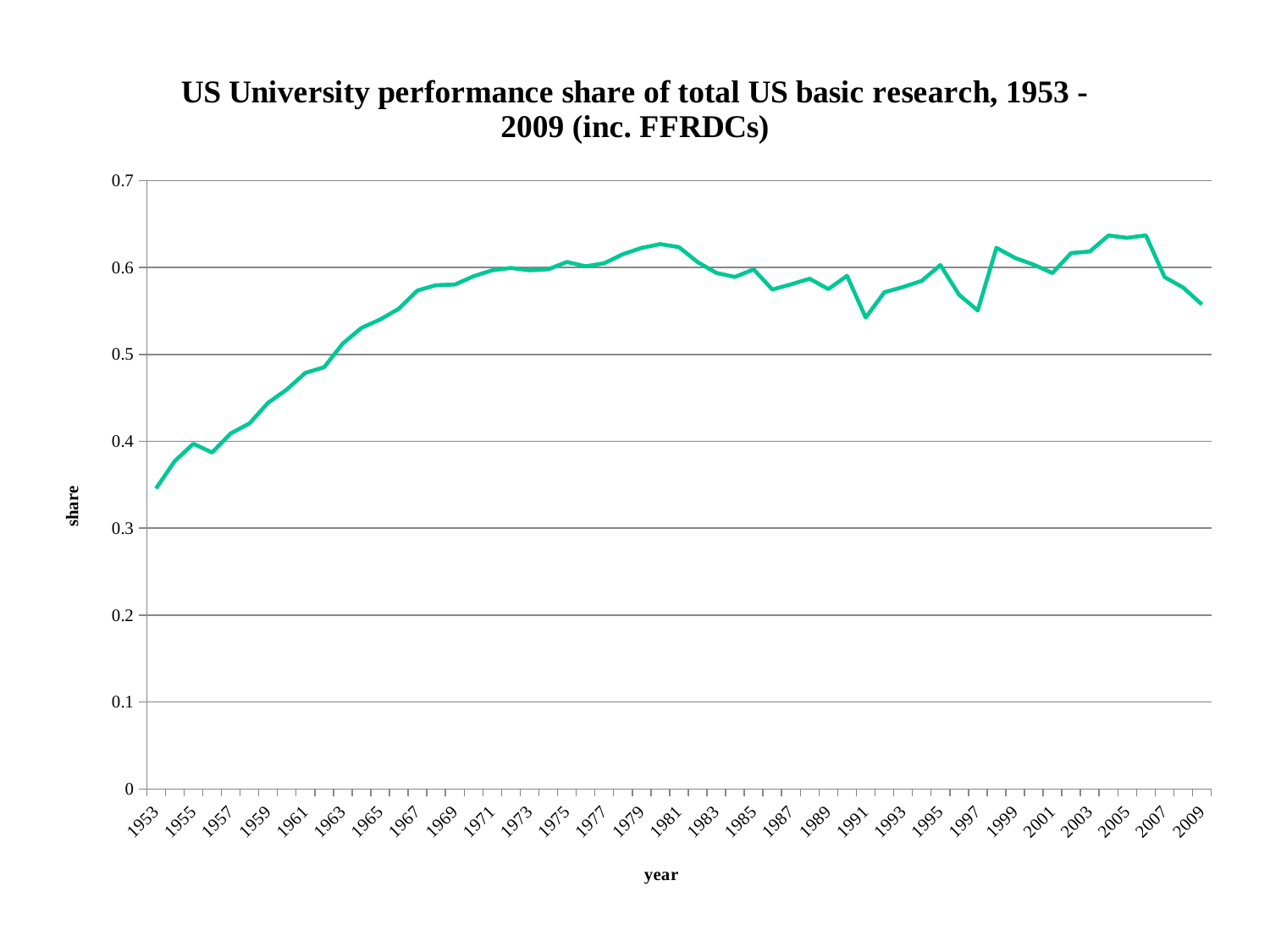
Is the value for 1953 greater or less than 0.4? less Is the value for 1969 greater or less than 0.6? less What kind of chart is shown on the slide? line chart Which year has the lowest share on the chart? 1953 What is the label on the vertical axis of the chart? share Does the share rise or fall between 1953 and 1971? rise Is the value for 1965 greater or less than 0.5? greater Which year has the larger share, 1953 or 2009? 2009 What is the title of the chart? US University performance share of total US basic research, 1953 - 2009 (inc. FFRDCs)